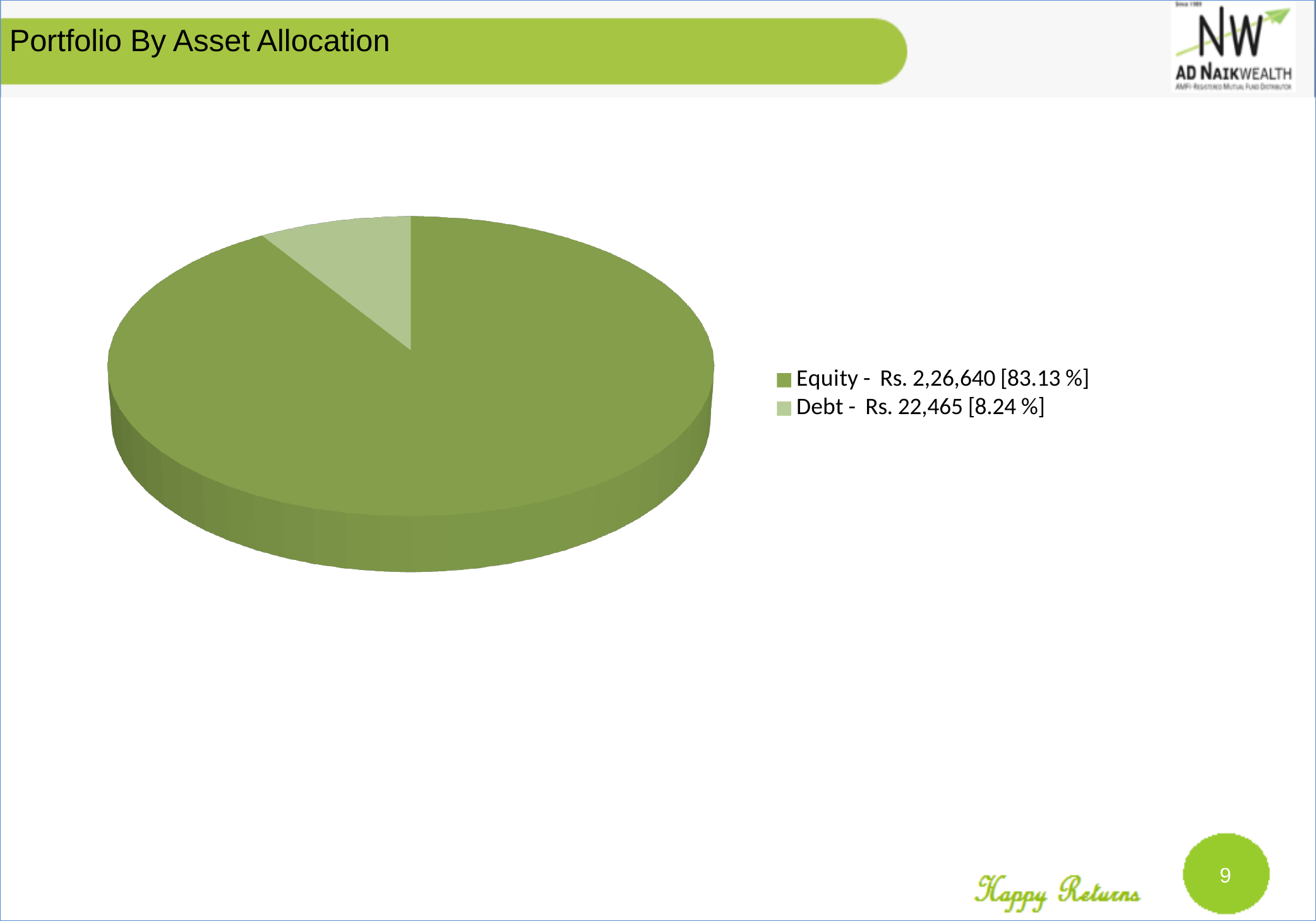
What percentage share does Debt have in the pie chart? 8.24 % How many slices does the pie chart have? 2 Which is larger in the pie chart, Equity or Debt? Equity What percentage share does Equity have in the pie chart? 83.13 % What is the value of the Equity slice in the pie chart? Rs. 2,26,640 What is the title of the slide containing the chart? Portfolio By Asset Allocation What kind of chart is shown on the slide? Pie chart What is the difference in rupees between the Equity and Debt values shown in the legend? Rs. 2,04,175 Which asset class has the largest slice in the pie chart? Equity By how many percentage points does the Equity share exceed the Debt share? 74.89 % Which asset class has the smallest slice in the pie chart? Debt What is the value of the Debt slice in the pie chart? Rs. 22,465